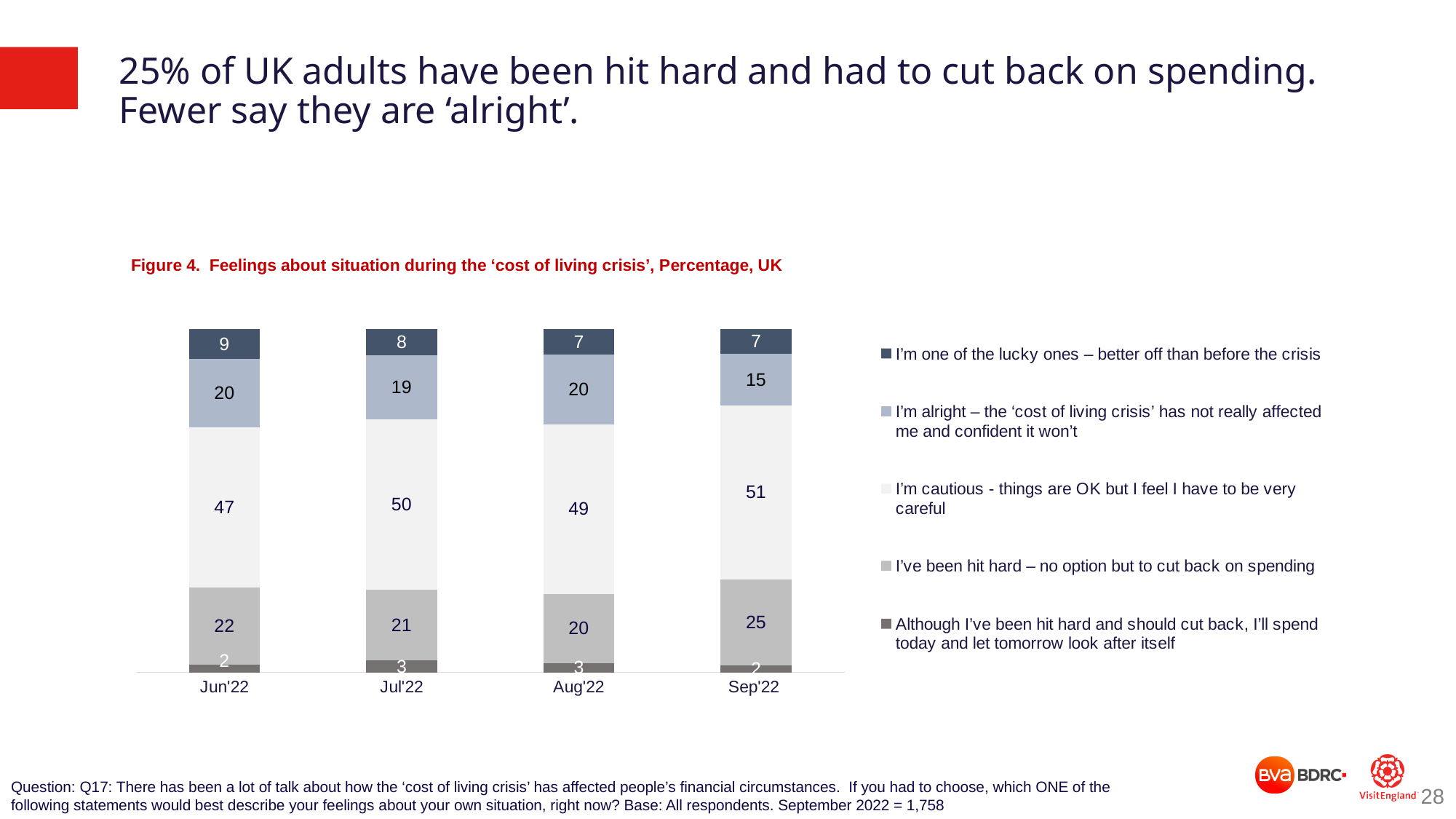
What is the value for 'I'm one of the lucky ones – better off than before the crisis' in Jun'22? 9 What is the title of the figure on the slide? Figure 4. Feelings about situation during the 'cost of living crisis', Percentage, UK Which is larger: the 'I'm alright' value in Jun'22 or in Sep'22? Jun'22 What is the difference between the 'I'm cautious' values for Sep'22 and Jun'22? 4 What percentage of respondents in Sep'22 said they had been hit hard with no option but to cut back on spending? 25 In which month is the 'I'm alright' segment lowest? Sep'22 What is the value for 'I'm alright – the cost of living crisis has not really affected me' in Sep'22? 15 How many series does the legend list? 5 What type of chart is shown on the slide? Stacked bar chart In which month is the 'I've been hit hard – no option but to cut back on spending' segment highest? Sep'22 How many months are shown on the x axis of the chart? 4 What is the value for 'I'm cautious - things are OK but I feel I have to be very careful' in Jul'22? 50